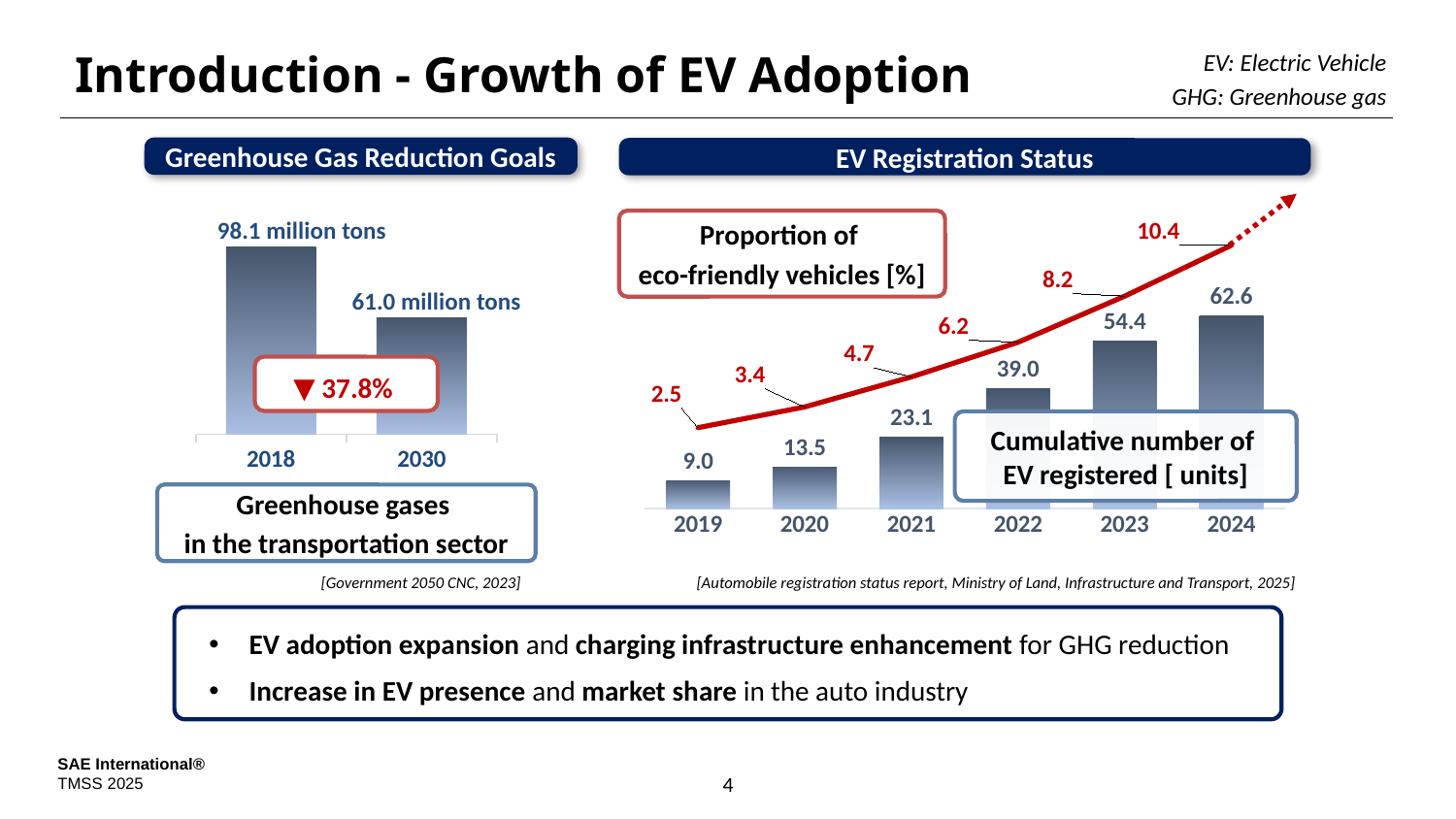
In the EV Registration Status chart, what is the difference in cumulative EV registered between 2024 and 2023? 8.2 In the EV Registration Status chart, which year has the lowest cumulative number of EV registered? 2019 In the EV Registration Status chart, how many years are shown on the x axis? 6 In the EV Registration Status chart, does the proportion of eco-friendly vehicles rise or fall from 2019 to 2024? rise In the EV Registration Status chart, which year has the highest proportion of eco-friendly vehicles? 2024 In the Greenhouse Gas Reduction Goals chart, what percentage reduction is shown between 2018 and 2030? ▼ 37.8% In the Greenhouse Gas Reduction Goals chart, what is the value for 2018? 98.1 million tons In the Greenhouse Gas Reduction Goals chart, what is the value for 2030? 61.0 million tons What type of chart is the Greenhouse Gas Reduction Goals chart? bar chart In the EV Registration Status chart, what is the proportion of eco-friendly vehicles in 2024? 10.4 In the Greenhouse Gas Reduction Goals chart, which year has the higher value, 2018 or 2030? 2018 In the EV Registration Status chart, what is the cumulative number of EV registered in 2022? 39.0